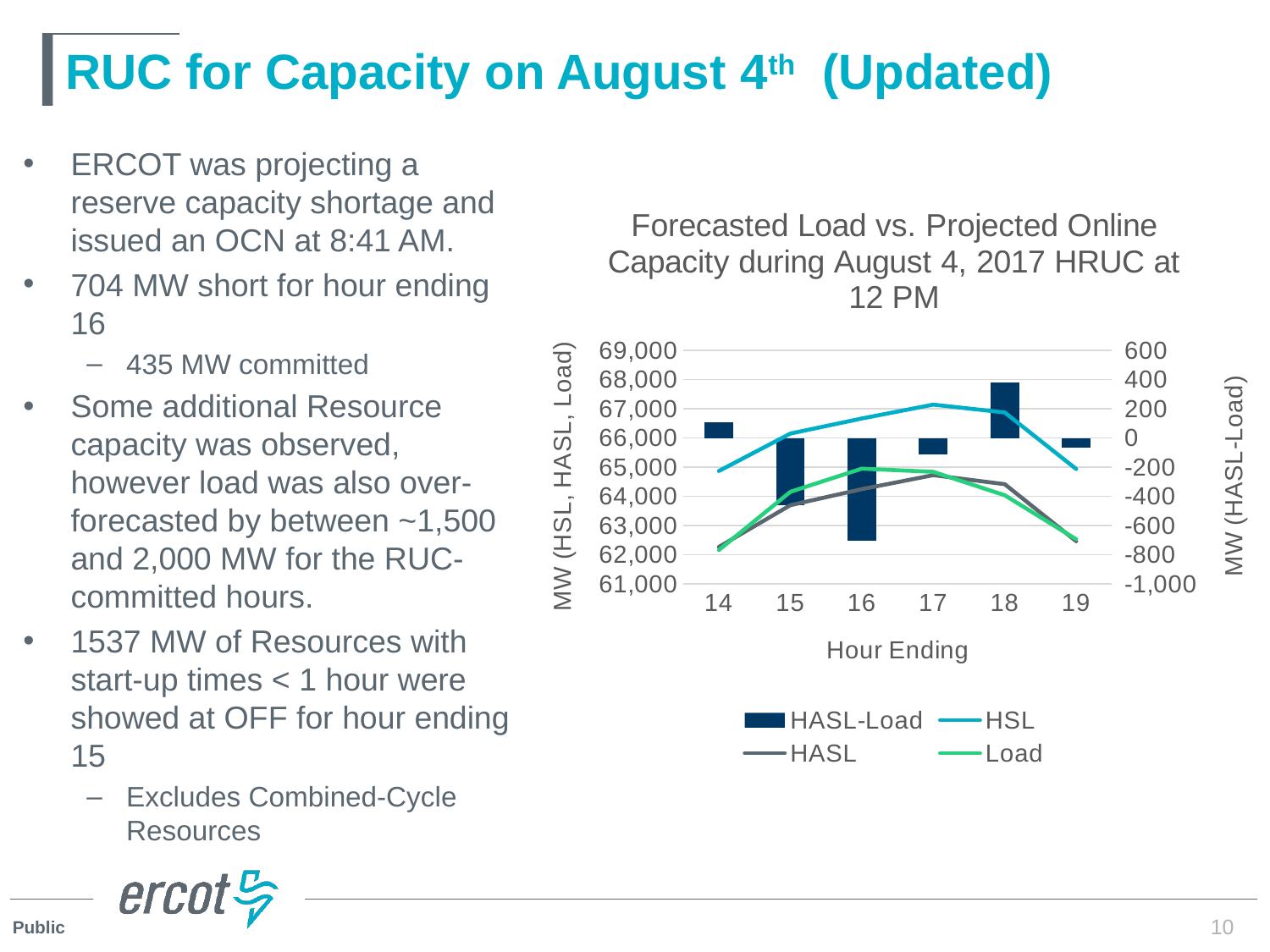
Is the HASL-Load value at hour ending 16 greater or less than -400? less At which hour ending is the HASL-Load bar the highest? 18 Does the HSL line rise or fall from hour ending 14 to hour ending 17? rise What is the title of the x axis of the chart? Hour Ending What kind of chart is shown on the slide? A combination bar and line chart Is the HSL value at hour ending 17 greater or less than 66,000? greater At hour ending 16, which is larger, HSL or Load? HSL At which hour ending is the HASL-Load bar the lowest? 16 How many series does the chart legend list? 4 At hour ending 15, which is larger, Load or HASL? Load How many hour-ending categories are plotted on the x axis? 6 Is the Load value at hour ending 14 greater or less than 63,000? less